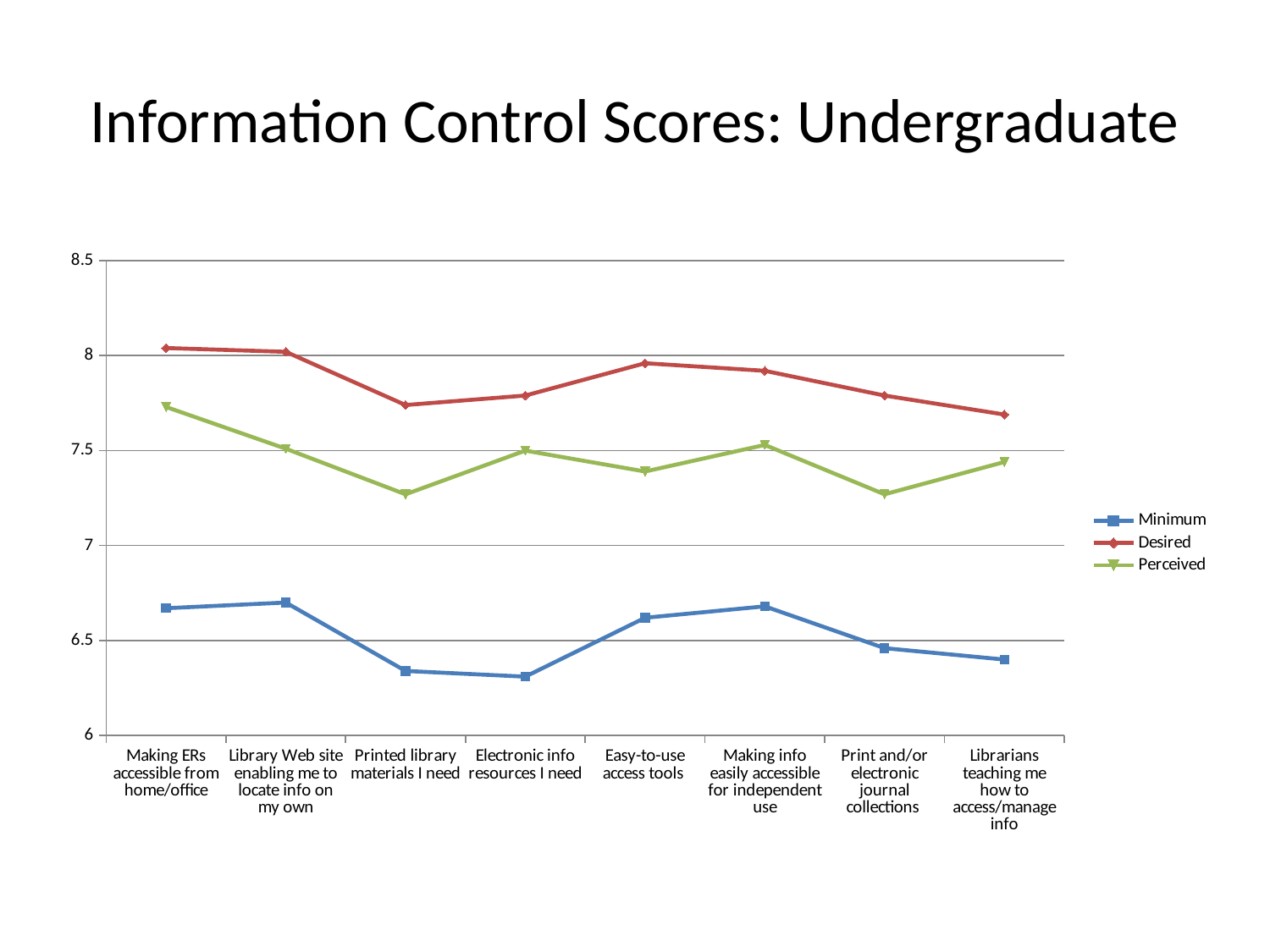
Is the Minimum value for Easy-to-use access tools greater or less than 6.5? greater How many series does the legend list? 3 Is the Perceived value for Printed library materials I need greater or less than 7.5? less For Electronic info resources I need, which is larger, the Desired score or the Perceived score? Desired Which is larger, the Minimum score for Library Web site enabling me to locate info on my own or for Printed library materials I need? Library Web site enabling me to locate info on my own What kind of chart is shown on the slide? Line chart Does the Desired line rise or fall from Easy-to-use access tools to Librarians teaching me how to access/manage info? Fall How many categories are plotted along the x axis? 8 Is the Desired value for Printed library materials I need greater or less than 8? less Which series is drawn in red? Desired Which category has the highest Perceived score? Making ERs accessible from home/office